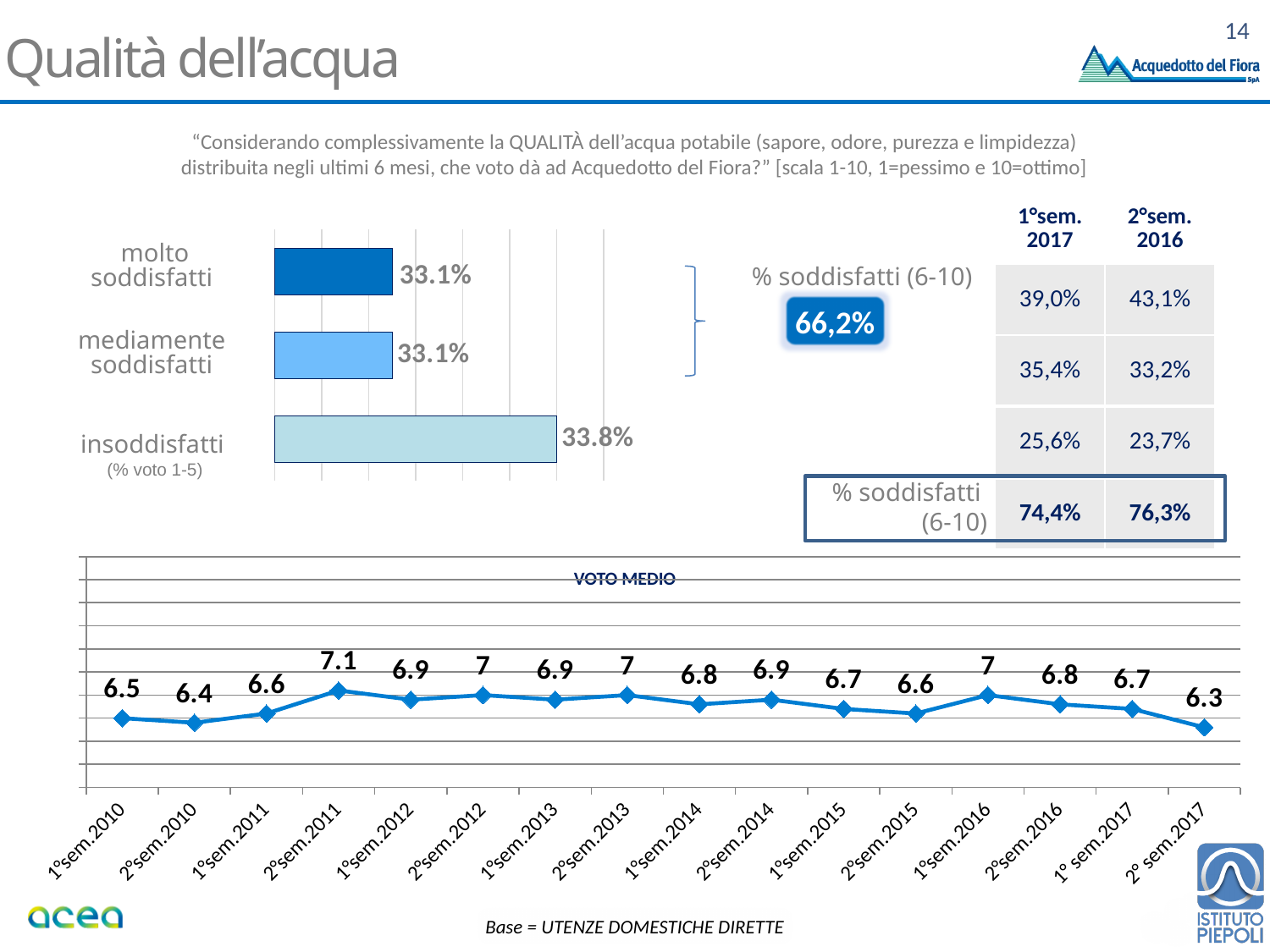
How many data points does the 'VOTO MEDIO' line chart show? 16 What kind of chart is the chart at the top left of the slide? bar chart In the 'VOTO MEDIO' line chart, which period has the highest value? 2°sem.2011 How many categories does the bar chart show? 3 In the 'VOTO MEDIO' line chart, what is the value for 2°sem.2011? 7.1 In the 'VOTO MEDIO' line chart, what is the value for 2° sem.2017? 6.3 In the bar chart, which category has the highest value? insoddisfatti In the 'VOTO MEDIO' line chart, which period has the lowest value? 2° sem.2017 In the bar chart, what is the difference between 'insoddisfatti' and 'mediamente soddisfatti'? 0.7% In the bar chart, what is the value for 'insoddisfatti'? 33.8% In the bar chart, what is the value for 'molto soddisfatti'? 33.1% In the 'VOTO MEDIO' line chart, which is larger: the value for 1°sem.2010 or the value for 2°sem.2010? 1°sem.2010